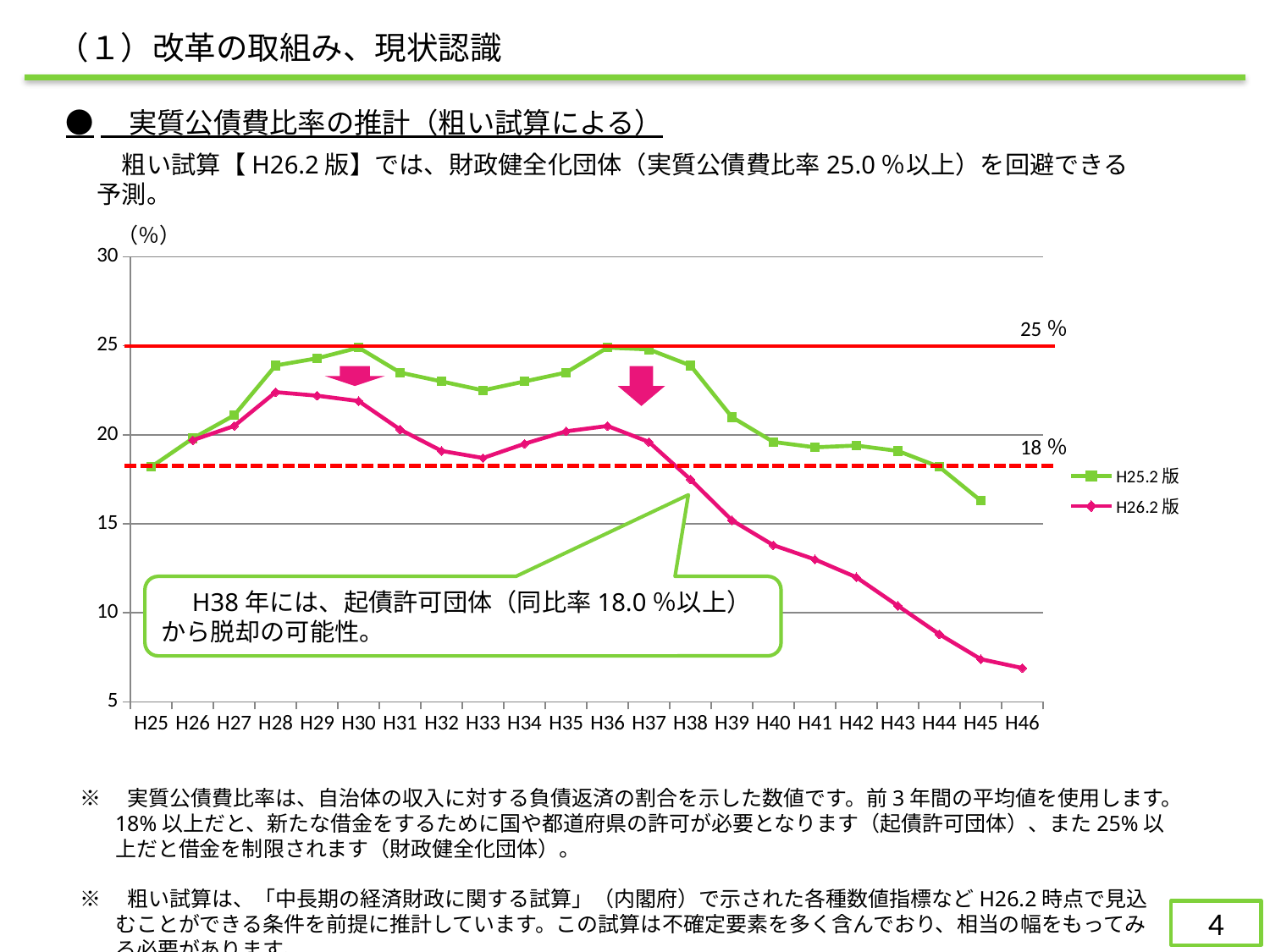
Is the value for H25.2版 at H30 greater or less than 20? greater Which year has the lowest value for the H25.2版 series? H45 Which year has the lowest value for the H26.2版 series? H46 Is the value for H26.2版 at H40 greater or less than 15? less What value does the solid red horizontal line mark? 25% At H44, which series has the larger value, H25.2版 or H26.2版? H25.2版 Is the value for H26.2版 at H46 greater or less than 10? less How many series does the legend list? 2 What kind of chart is shown on the slide? line chart How many years are shown along the x axis? 22 Does the H26.2版 series rise or fall from H37 to H46? fall